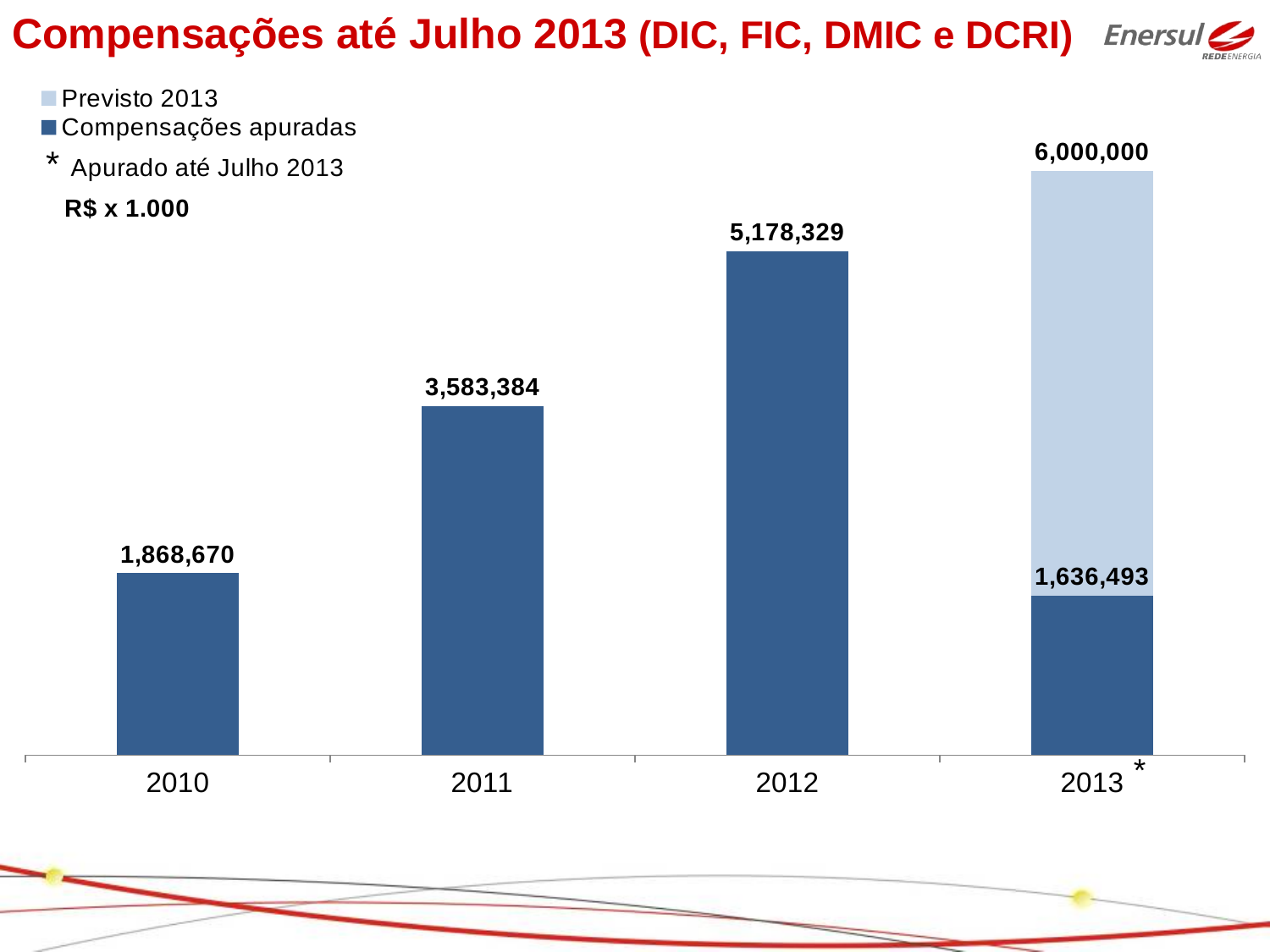
How many series does the legend list? 2 What is the value of Compensações apuradas for 2011? 3,583,384 Which year has the lowest value of Compensações apuradas? 2013 Which year has the highest value of Compensações apuradas? 2012 What is the value of Compensações apuradas for 2013? 1,636,493 How many years are shown on the x axis? 4 What is the value of Compensações apuradas for 2010? 1,868,670 What is the difference between the Compensações apuradas values for 2012 and 2011? 1,594,945 What is the value of Compensações apuradas for 2012? 5,178,329 What kind of chart is shown on the slide? Bar chart Do the Compensações apuradas values rise or fall from 2010 to 2012? Rise Which is larger, the Compensações apuradas value for 2010 or for 2013? 2010